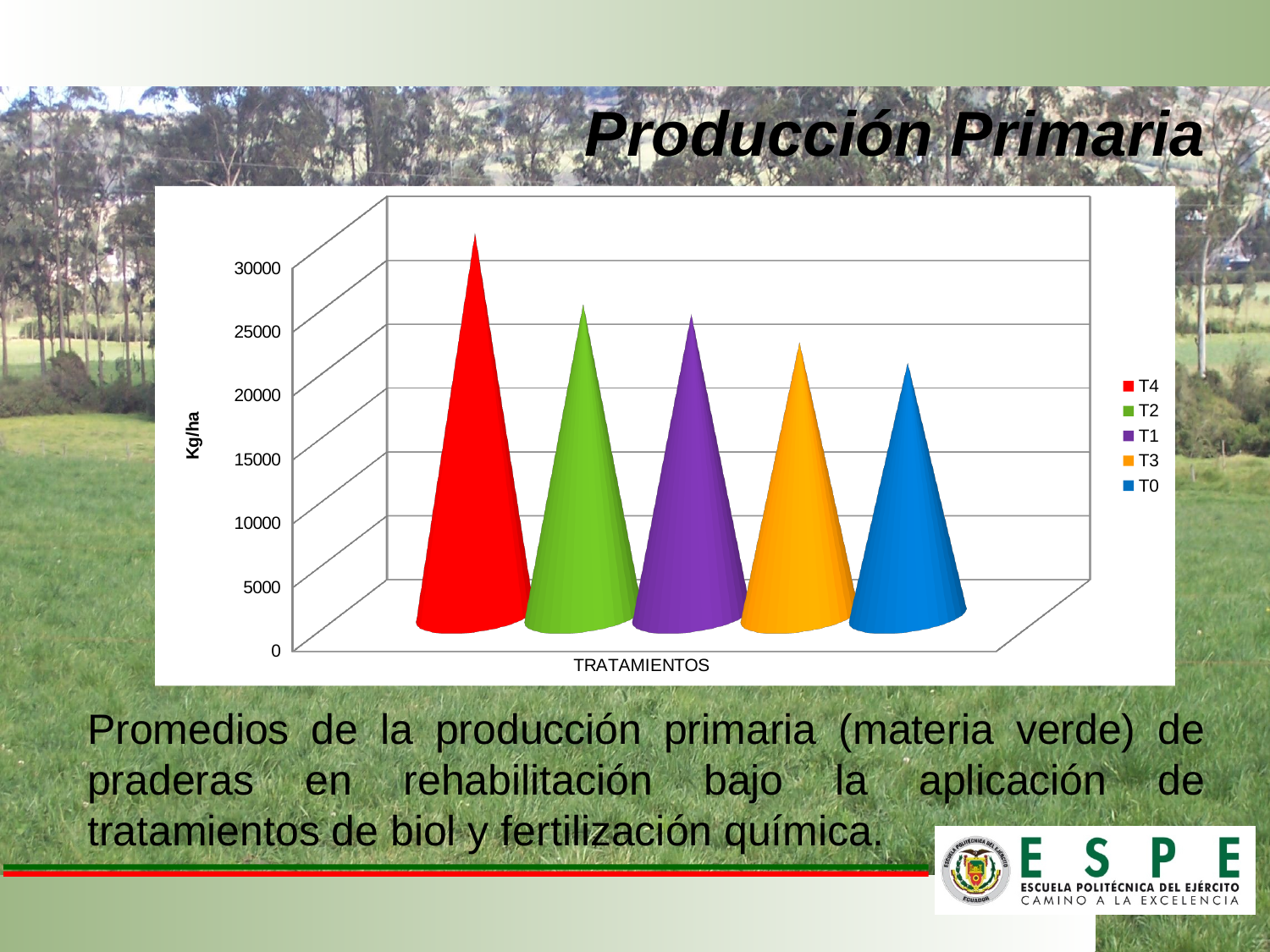
What is the label on the vertical axis of the chart? Kg/ha Is the value for T0 greater or less than 25000? less Which treatment has the highest production value? T4 Which has a larger value, T2 or T0? T2 Which treatment has the lowest production value? T0 How many bars are plotted in the chart? 5 Is the value for T4 greater or less than 25000? greater How many series does the legend list? 5 Is the value for T1 greater or less than 15000? greater What kind of chart is shown on the slide? bar chart Which has a larger value, T4 or T0? T4 Do the values rise or fall from left to right across the bars? fall